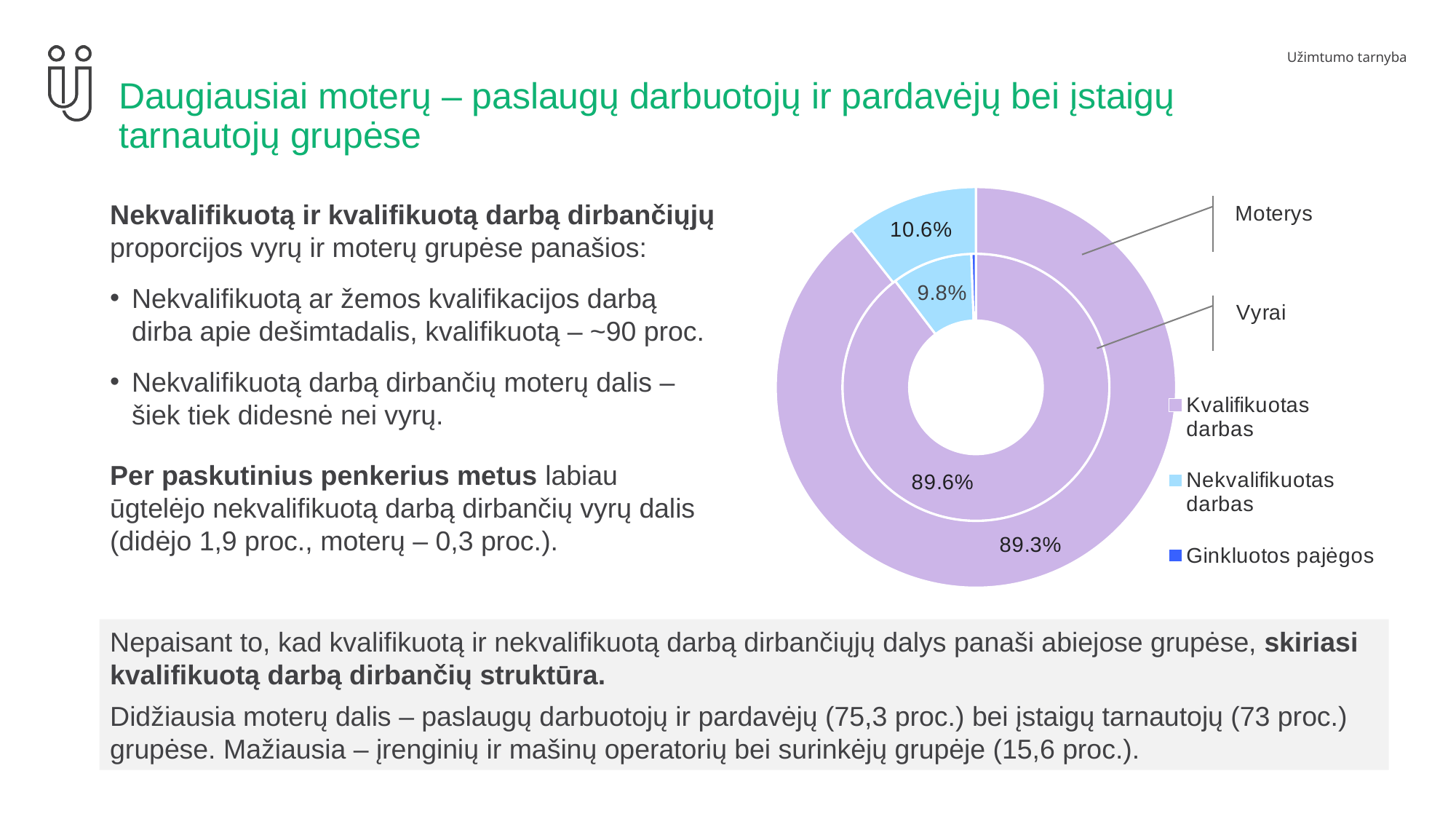
By how many percentage points does the Kvalifikuotas darbas share for Vyrai exceed that for Moterys? 0.3 percentage points What is the share of Kvalifikuotas darbas in the Moterys ring? 89.3% Which ring of the doughnut chart represents Moterys, the outer or the inner? Outer What is the share of Nekvalifikuotas darbas in the Moterys ring? 10.6% How many categories does the chart legend list? 3 What is the share of Nekvalifikuotas darbas in the Vyrai ring? 9.8% By how many percentage points does the Nekvalifikuotas darbas share for Moterys exceed that for Vyrai? 0.8 percentage points What kind of chart is shown on the slide? Doughnut chart Which category takes the largest share of the Moterys ring? Kvalifikuotas darbas Which category takes the smallest share of the Vyrai ring? Ginkluotos pajėgos What is the share of Kvalifikuotas darbas in the Vyrai ring? 89.6% Which group has the larger share of Nekvalifikuotas darbas, Moterys or Vyrai? Moterys